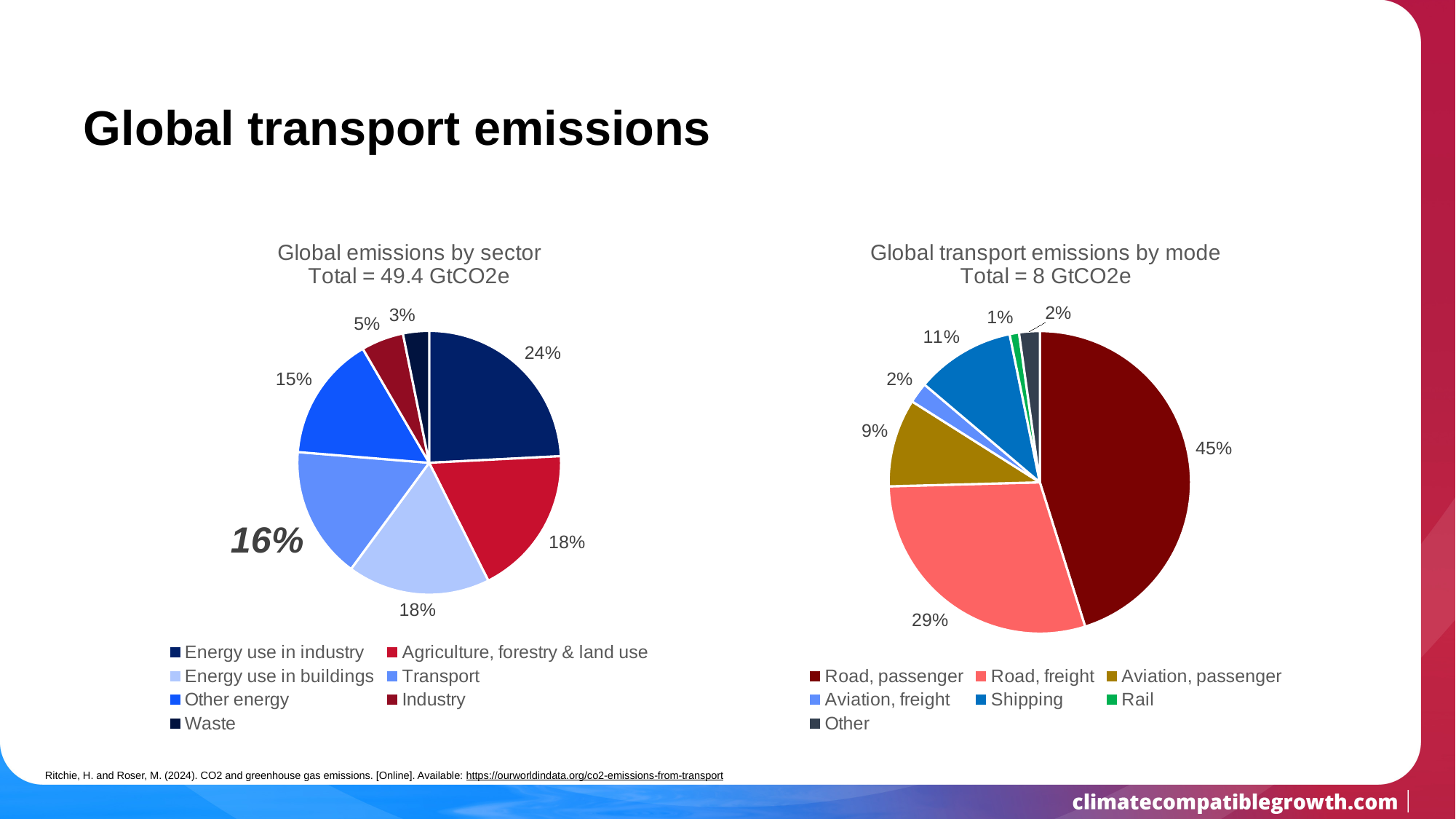
In the 'Global emissions by sector' chart, what share of emissions comes from Transport? 16% In the 'Global emissions by sector' chart, what is the difference in percentage points between Energy use in industry and Other energy? 9 In the 'Global transport emissions by mode' chart, what share of transport emissions comes from Shipping? 11% In the 'Global emissions by sector' chart, what total is stated in the chart title? 49.4 GtCO2e What type of chart is used for both charts on the slide? Pie chart In the 'Global emissions by sector' chart, which sector has the smallest share? Waste In the 'Global emissions by sector' chart, how many sectors are shown in the legend? 7 In the 'Global transport emissions by mode' chart, which mode has the largest share? Road, passenger In the 'Global emissions by sector' chart, which sector has the largest share? Energy use in industry In the 'Global transport emissions by mode' chart, which is larger: Aviation, passenger or Shipping? Shipping In the 'Global transport emissions by mode' chart, which mode has the smallest share? Rail In the 'Global transport emissions by mode' chart, what is the difference in percentage points between Road, passenger and Road, freight? 16